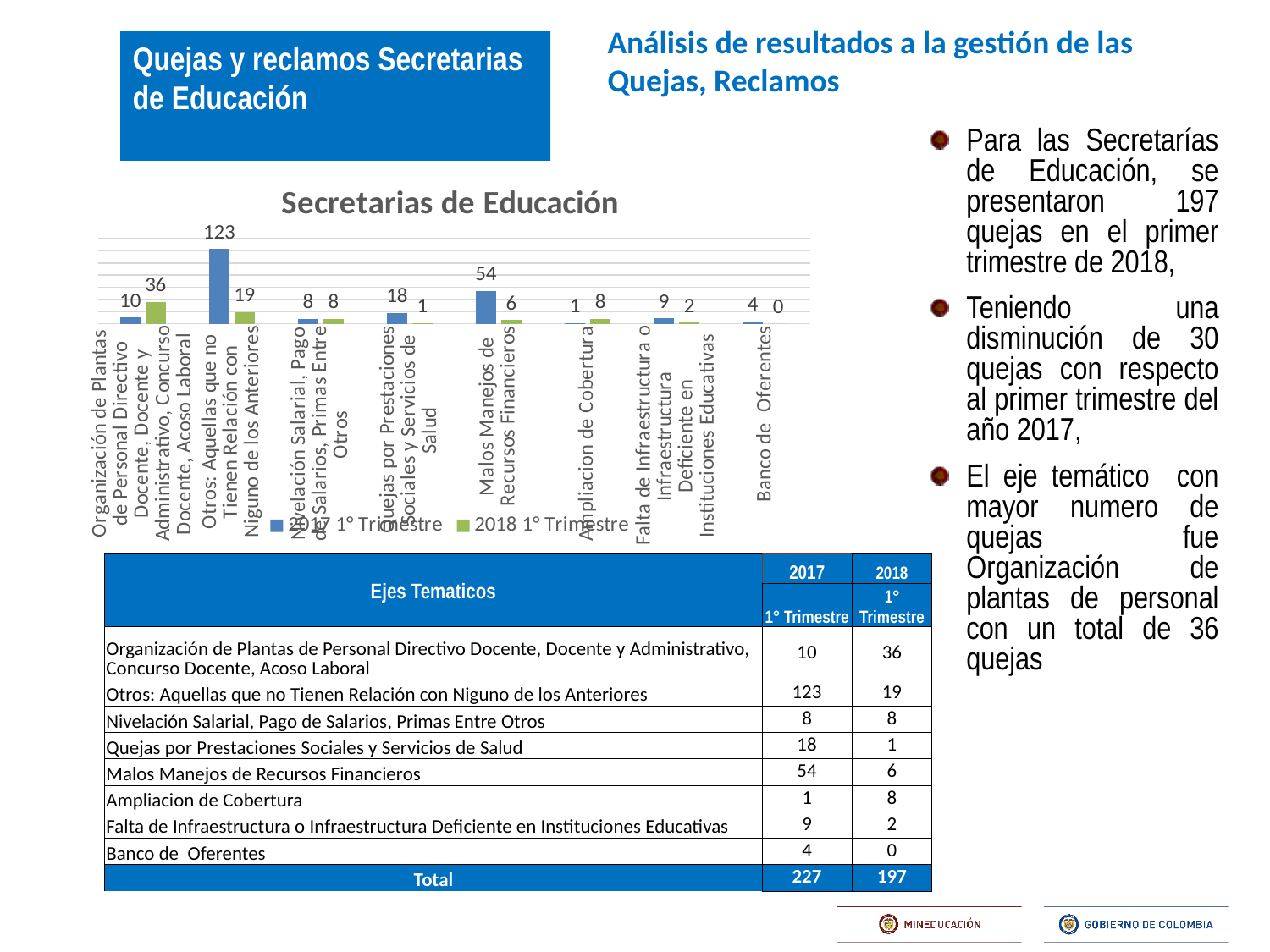
Which category has the highest value in the 2017 1° Trimestre series? Otros: Aquellas que no Tienen Relación con Niguno de los Anteriores What is the value for 'Quejas por Prestaciones Sociales y Servicios de Salud' in the 2017 1° Trimestre series? 18 How many series does the legend of the chart list? 2 Which colour represents the 2018 1° Trimestre series in the chart? green For 'Organización de Plantas de Personal Directivo Docente, Docente y Administrativo, Concurso Docente, Acoso Laboral', which series has the larger value, 2017 1° Trimestre or 2018 1° Trimestre? 2018 1° Trimestre What is the value for 'Otros: Aquellas que no Tienen Relación con Niguno de los Anteriores' in the 2017 1° Trimestre series? 123 What type of chart is shown on the slide? bar chart What is the difference between the 2017 1° Trimestre and 2018 1° Trimestre values for 'Malos Manejos de Recursos Financieros'? 48 Which category has the lowest value in the 2018 1° Trimestre series? Banco de Oferentes What is the title of the chart? Secretarias de Educación What is the value for 'Malos Manejos de Recursos Financieros' in the 2018 1° Trimestre series? 6 How many categories are plotted on the x axis of the chart? 8